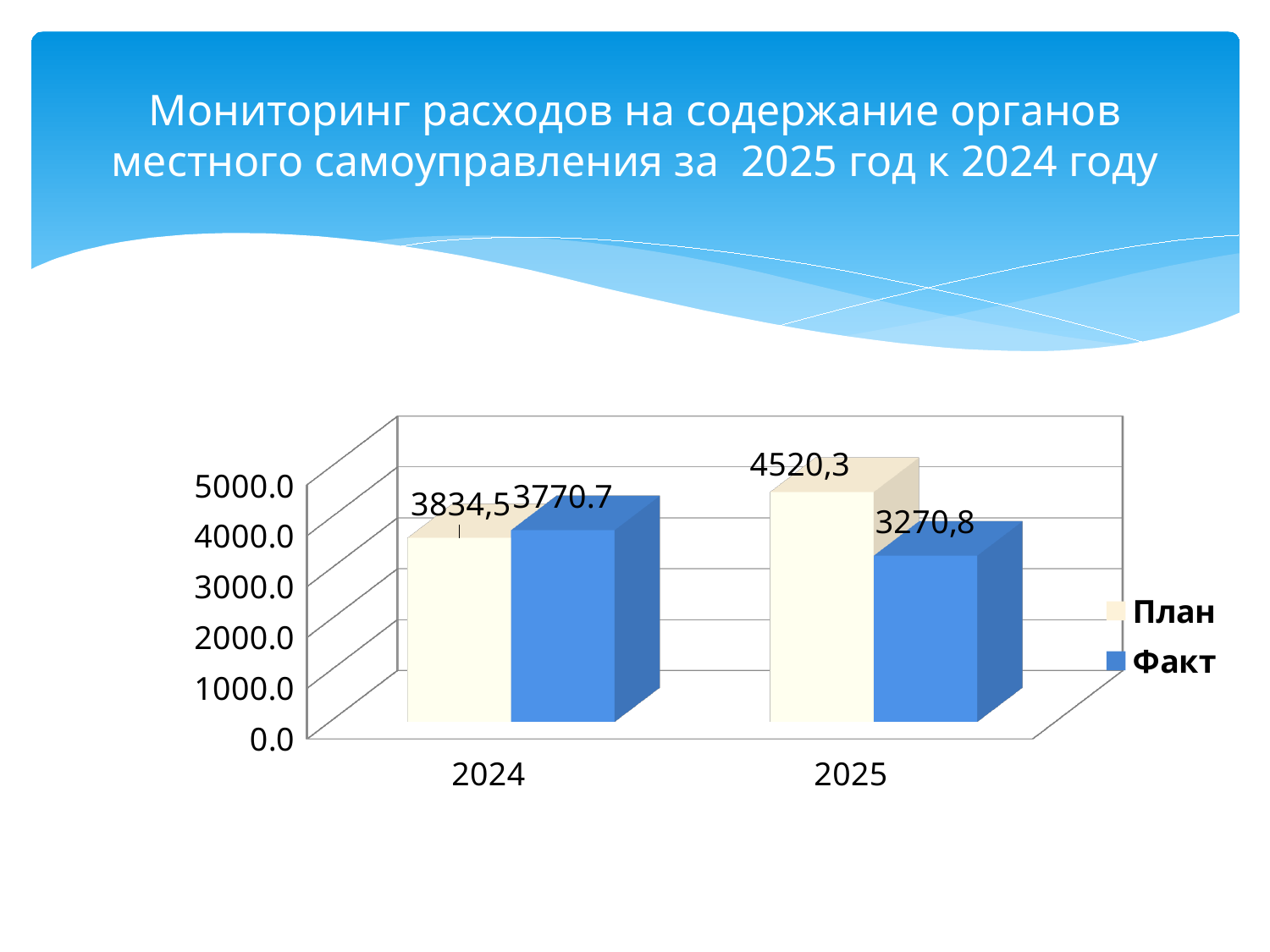
How many years are shown on the x axis? 2 Which year has the higher План value? 2025 What is the План value for 2024? 3834,5 Is the Факт value for 2025 larger or smaller than the Факт value for 2024? smaller Which series is shown in blue in the legend? Факт What is the Факт value for 2025? 3270,8 What is the Факт value for 2024? 3770.7 How many series does the legend list? 2 Which year has the lower Факт value? 2025 What kind of chart is shown on the slide? bar chart What is the difference between the План and Факт values for 2025? 1249,5 What is the План value for 2025? 4520,3